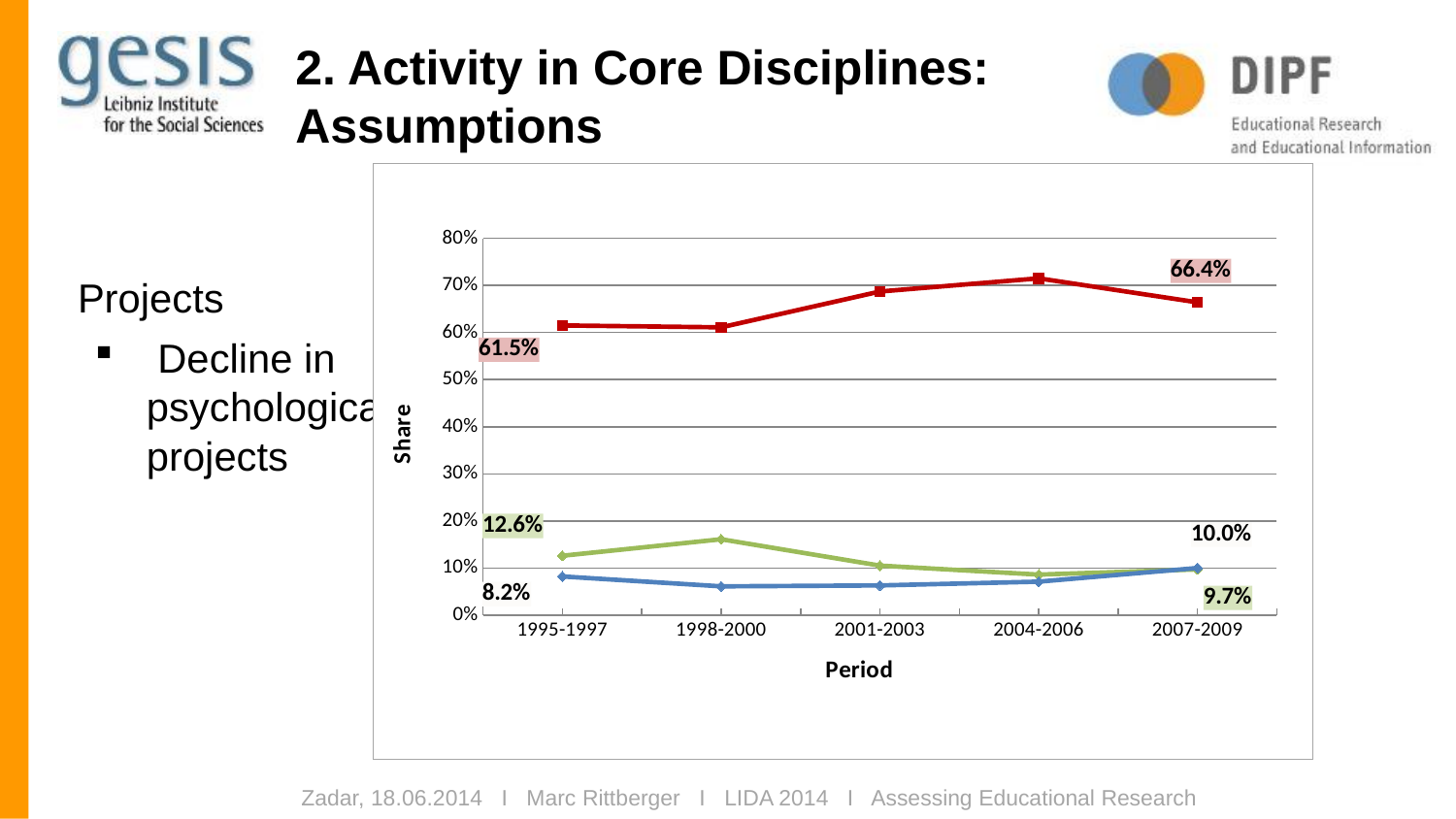
Which line has the highest values across all periods? the red line What is the value of the red line for the period 2007-2009? 66.4% What is the value of the green line for the period 1995-1997? 12.6% What is the value of the blue line for the period 1995-1997? 8.2% What is the label of the x axis of the chart? Period What is the value of the blue line for the period 2007-2009? 10.0% What type of chart is shown on the slide? line chart What is the value of the red line for the period 1995-1997? 61.5% How many periods are shown on the x axis of the chart? 5 What is the value of the green line for the period 2007-2009? 9.7% Is the value of the red line for 2004-2006 greater or less than 70%? greater By how many percentage points did the red line change from 1995-1997 to 2007-2009? 4.9%